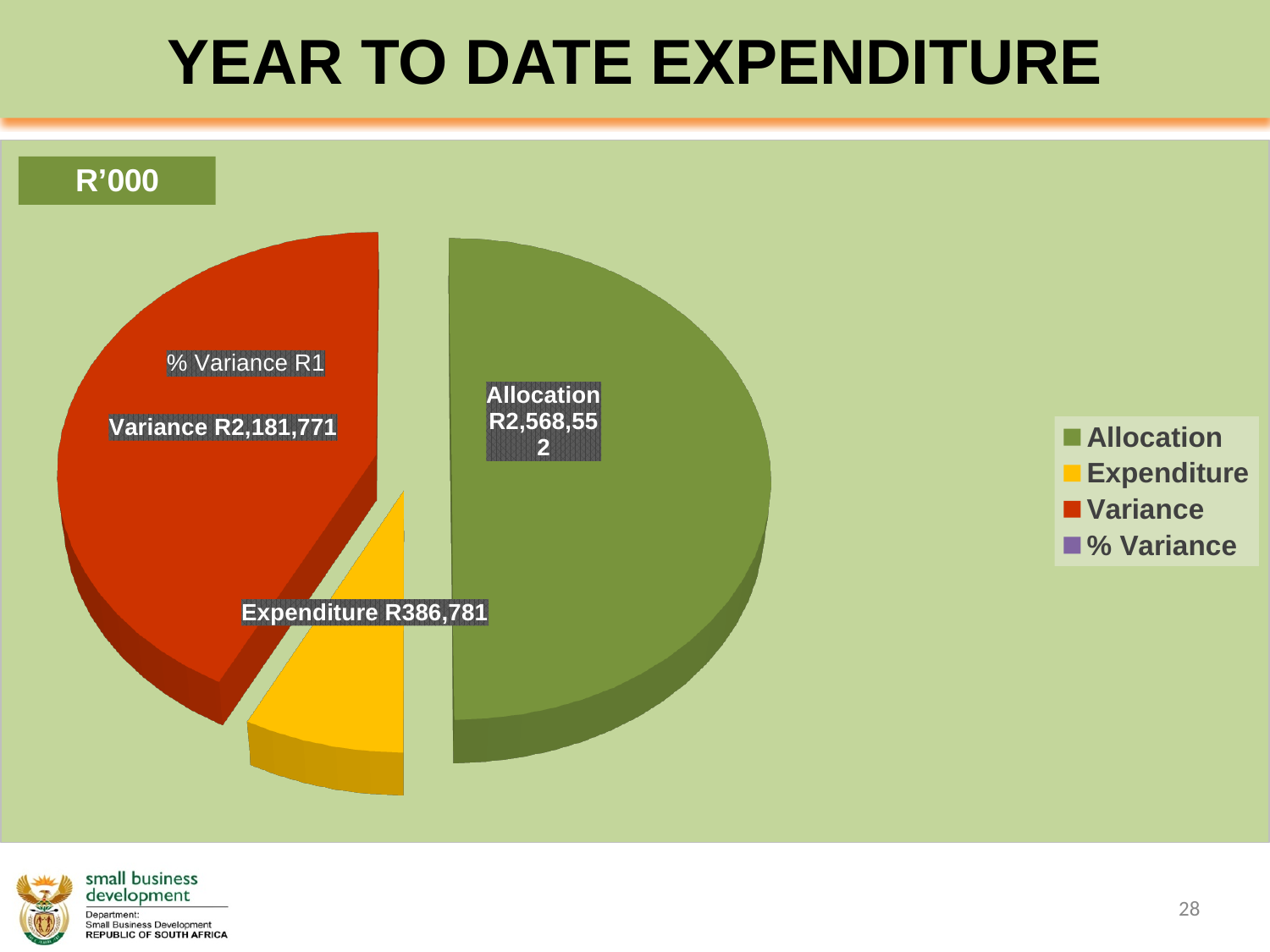
Which category has the largest value in the pie chart? Allocation What value is shown for % Variance? R1 What is the difference between the Allocation value and the Expenditure value? R2,181,771 How many entries does the legend list? 4 Which category has the smallest value in the pie chart? % Variance Which is larger, the Variance slice or the Expenditure slice? Variance What is the difference between the Allocation value and the Variance value? R386,781 What is the value of the Expenditure slice? R386,781 What is the value of the Variance slice? R2,181,771 What is the value of the Allocation slice? R2,568,552 What unit label is shown in the box above the chart? R'000 What kind of chart is shown on the slide? pie chart